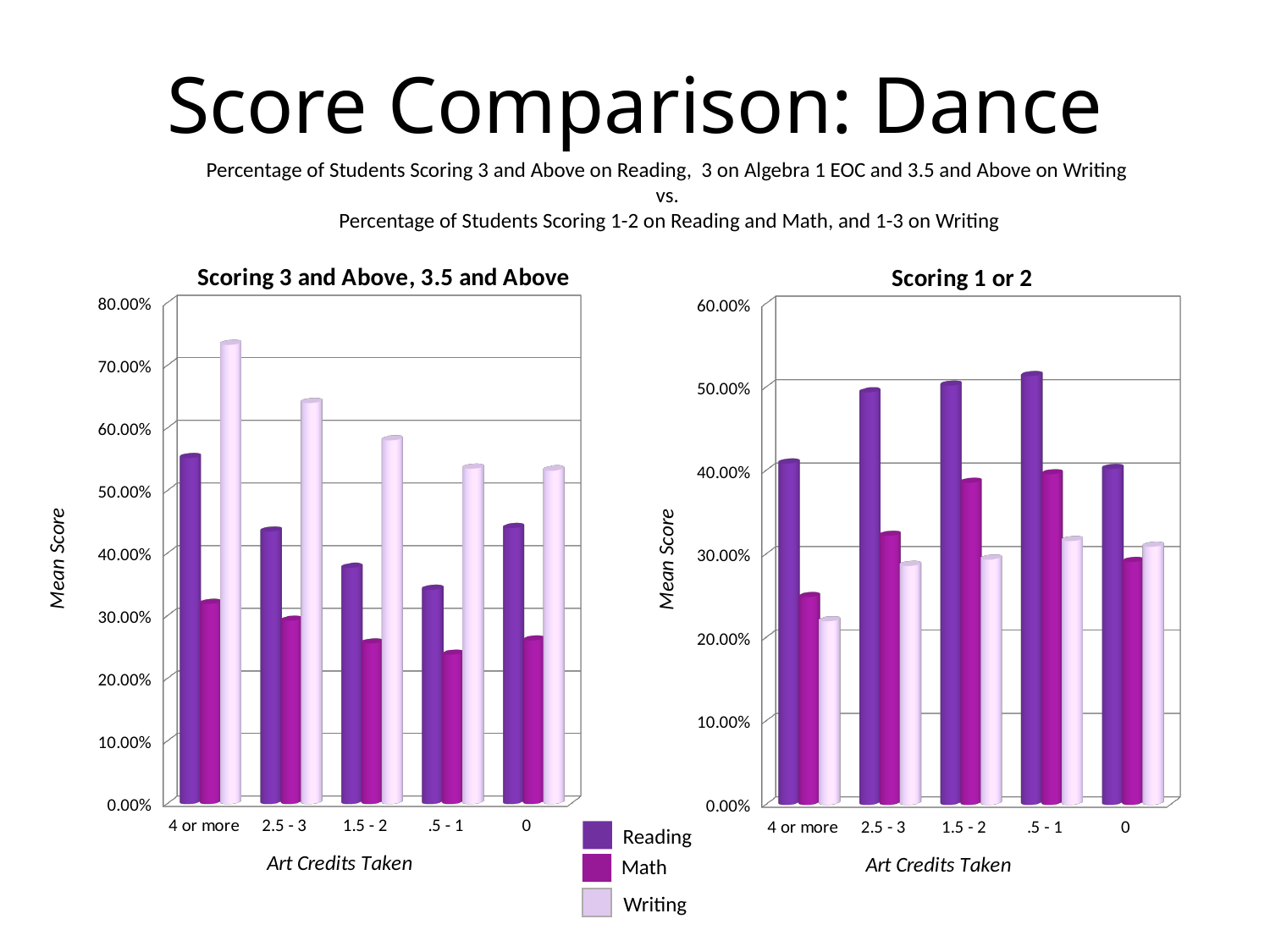
What type of chart is the chart titled "Scoring 3 and Above, 3.5 and Above"? Bar chart In the chart titled "Scoring 1 or 2", which art-credit category has the lowest Writing value? 4 or more In the chart titled "Scoring 3 and Above, 3.5 and Above", which art-credit category has the highest Writing value? 4 or more How many series does the legend list for the charts on this slide? 3 In the chart titled "Scoring 3 and Above, 3.5 and Above", which art-credit category has the lowest Reading value? .5 - 1 In the chart titled "Scoring 1 or 2", is the Math value for "4 or more" greater or less than 30.00%? less How many art-credit categories are shown on the x axis of the chart titled "Scoring 1 or 2"? 5 In the chart titled "Scoring 3 and Above, 3.5 and Above", which is larger for the "0" category: Reading or Math? Reading In the chart titled "Scoring 3 and Above, 3.5 and Above", is the Math value for ".5 - 1" greater or less than 30.00%? less In the chart titled "Scoring 3 and Above, 3.5 and Above", is the Writing value for "4 or more" greater or less than 70.00%? greater In the chart titled "Scoring 1 or 2", which is larger for the "1.5 - 2" category: Math or Writing? Math